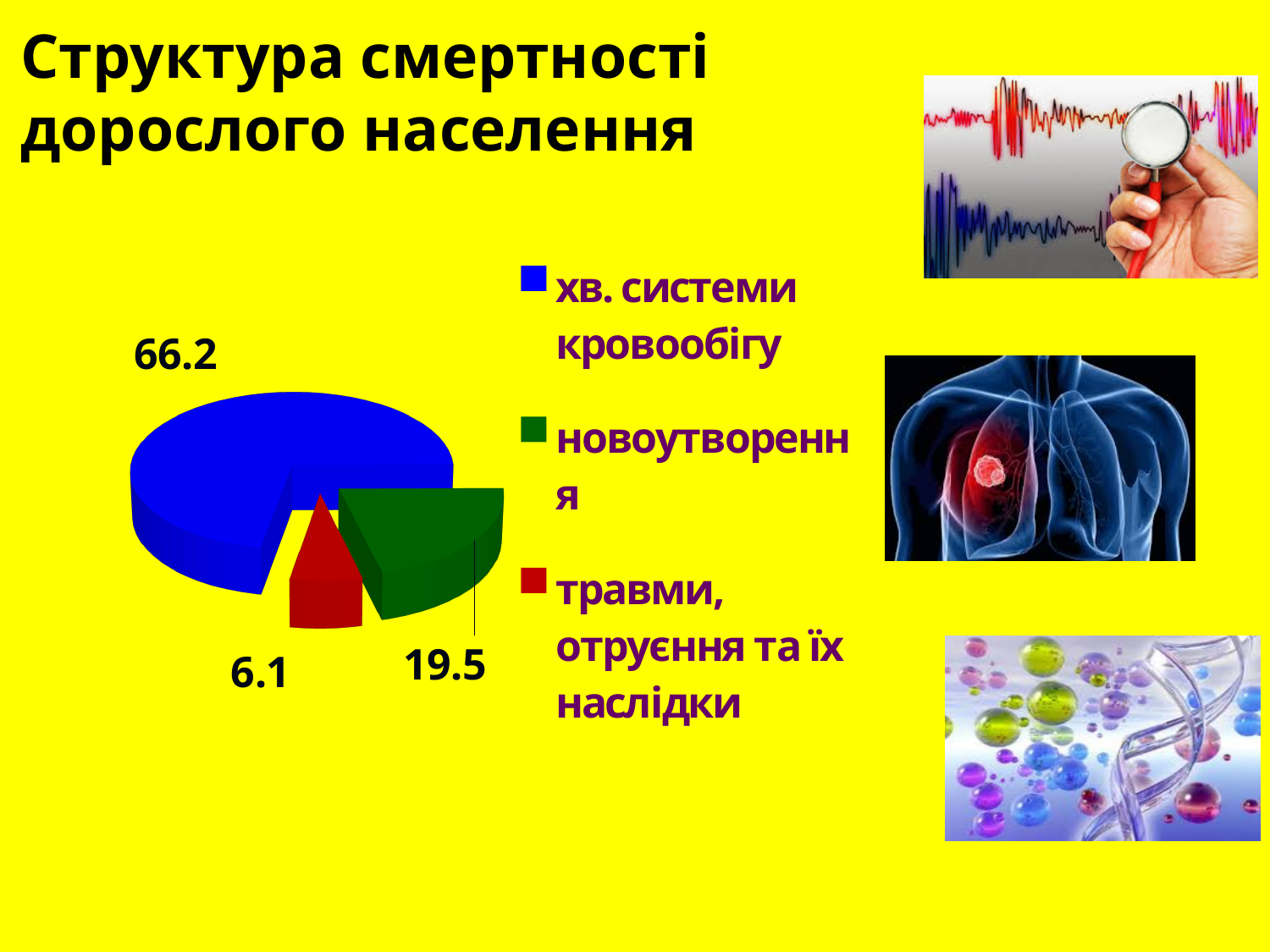
What is the value for травми, отруєння та їх наслідки? 6.1 Which category has the smallest slice of the pie? травми, отруєння та їх наслідки Which category has the largest slice of the pie? хв. системи кровообігу How many categories does the pie chart have? 3 What is the title of the slide containing the chart? Структура смертності дорослого населення What type of chart is shown on the slide? pie chart What is the value for новоутворення? 19.5 What is the difference between the values for новоутворення and травми, отруєння та їх наслідки? 13.4 What is the difference between the values for хв. системи кровообігу and новоутворення? 46.7 What colour is the slice for новоутворення? green What is the value for хв. системи кровообігу? 66.2 Which is larger, the value for новоутворення or the value for травми, отруєння та їх наслідки? новоутворення